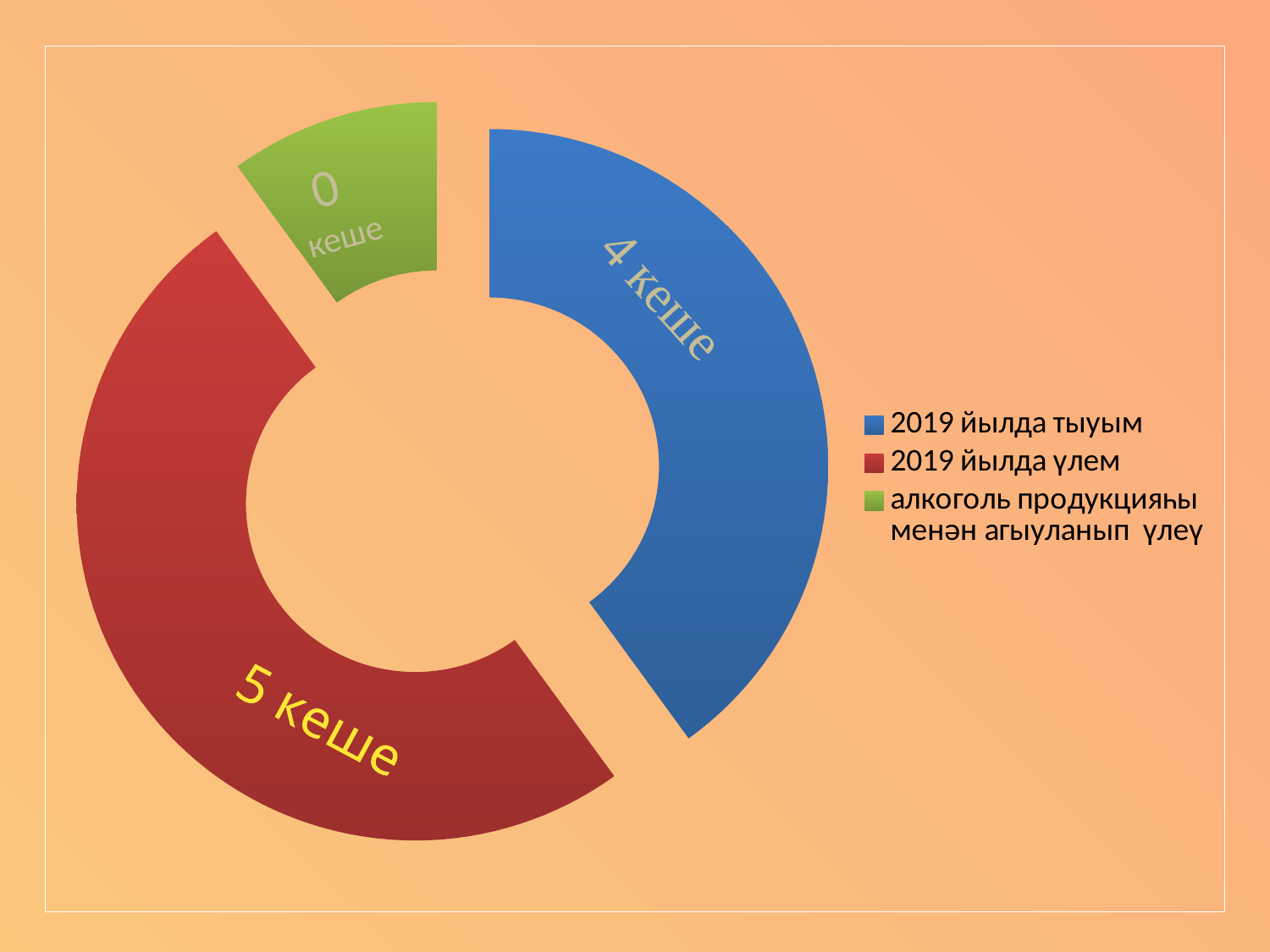
What colour is the segment for "2019 йылда тыуым"? blue What kind of chart is shown on the slide? doughnut chart Which category has the highest value? 2019 йылда үлем How many categories does the chart show? 3 What value is shown for the segment "алкоголь продукцияһы менән ағыуланып үлеү"? 0 кеше What value is shown for the segment "2019 йылда тыуым"? 4 кеше Which category has the lowest value? алкоголь продукцияһы менән ағыуланып үлеү Which is larger, the value for "2019 йылда тыуым" or the value for "2019 йылда үлем"? 2019 йылда үлем What value is shown for the segment "2019 йылда үлем"? 5 кеше What is the difference between the values for "2019 йылда үлем" and "2019 йылда тыуым"? 1 кеше Which category is shown in green? алкоголь продукцияһы менән ағыуланып үлеү How many entries does the legend list? 3